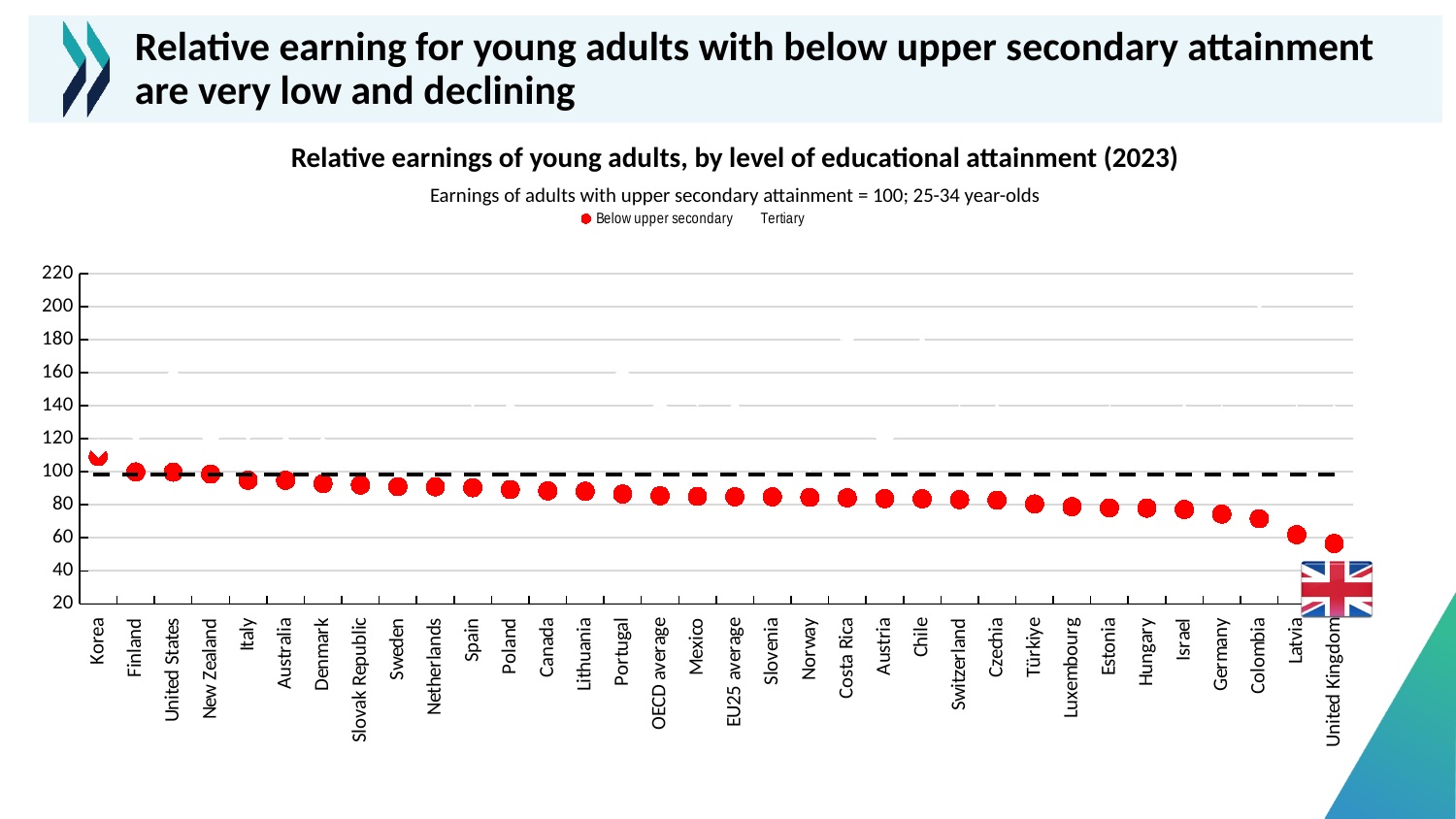
Which country has the lowest relative earnings for young adults with below upper secondary attainment? United Kingdom Which has a higher Below upper secondary value, Korea or the United Kingdom? Korea Which country has the highest relative earnings for young adults with below upper secondary attainment? Korea Do the Below upper secondary values rise or fall moving from left to right along the x axis? fall Is the value for Spain (Below upper secondary) greater or less than 100? less What type of chart is shown on the slide? Scatter (dot) chart How many countries or averages are shown on the x axis? 34 Is the value for Korea (Below upper secondary) greater or less than 100? greater Which has a higher Below upper secondary value, Finland or Colombia? Finland How many series does the legend list? 2 Is the value for Germany (Below upper secondary) greater or less than 80? less